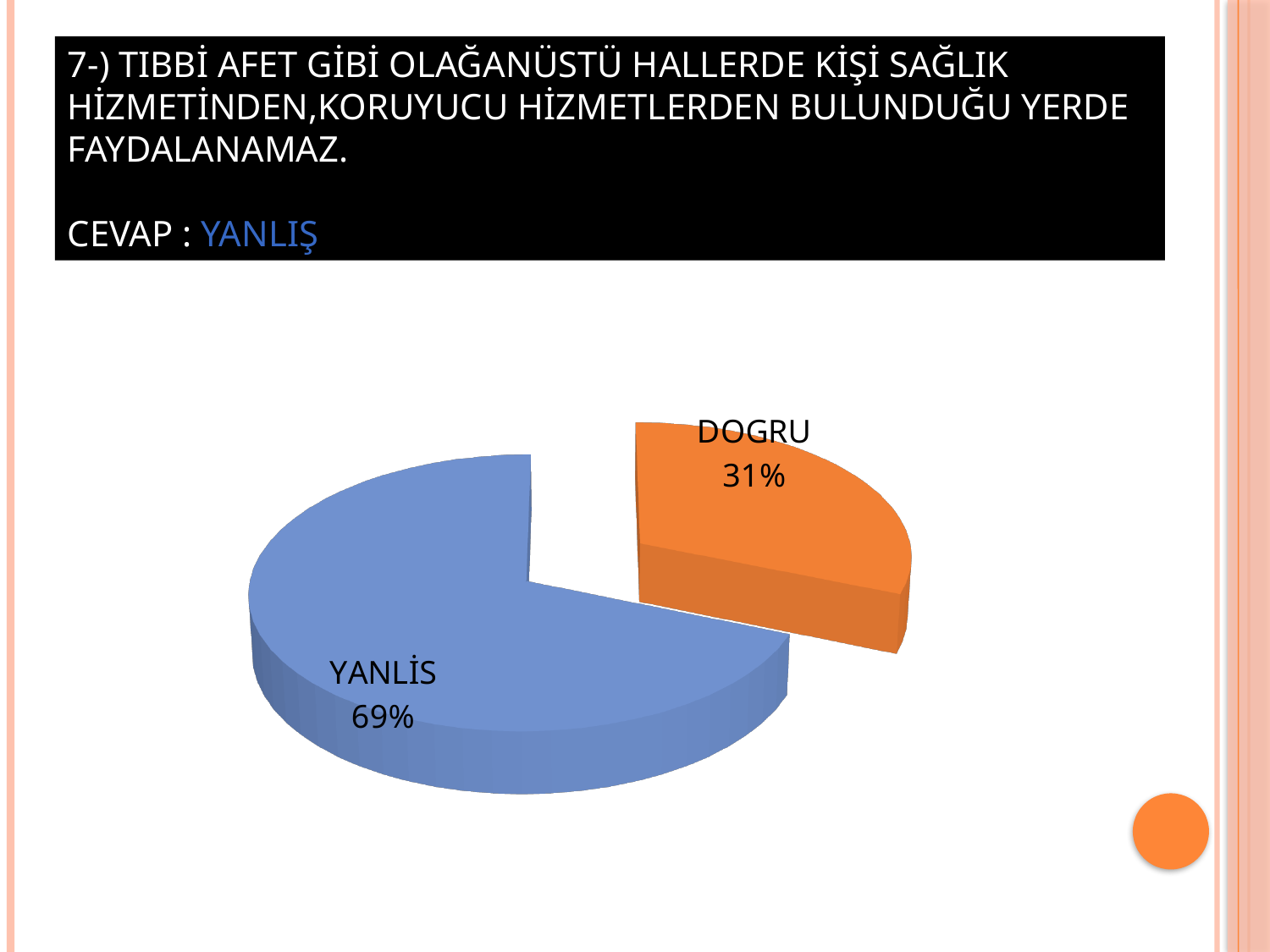
What percentage does the DOGRU slice show? 31% How many slices does the pie chart have? 2 What kind of chart is shown on the slide? pie chart What colour is the YANLİS slice? blue What is the difference in percentage points between the YANLİS and DOGRU slices? 38 Which is larger, the DOGRU slice or the YANLİS slice? YANLİS What percentage does the YANLİS slice show? 69% What colour is the DOGRU slice? orange Which slice of the pie is the smallest? DOGRU What share of the pie does the DOGRU slice represent? 31% Which slice of the pie is the largest? YANLİS